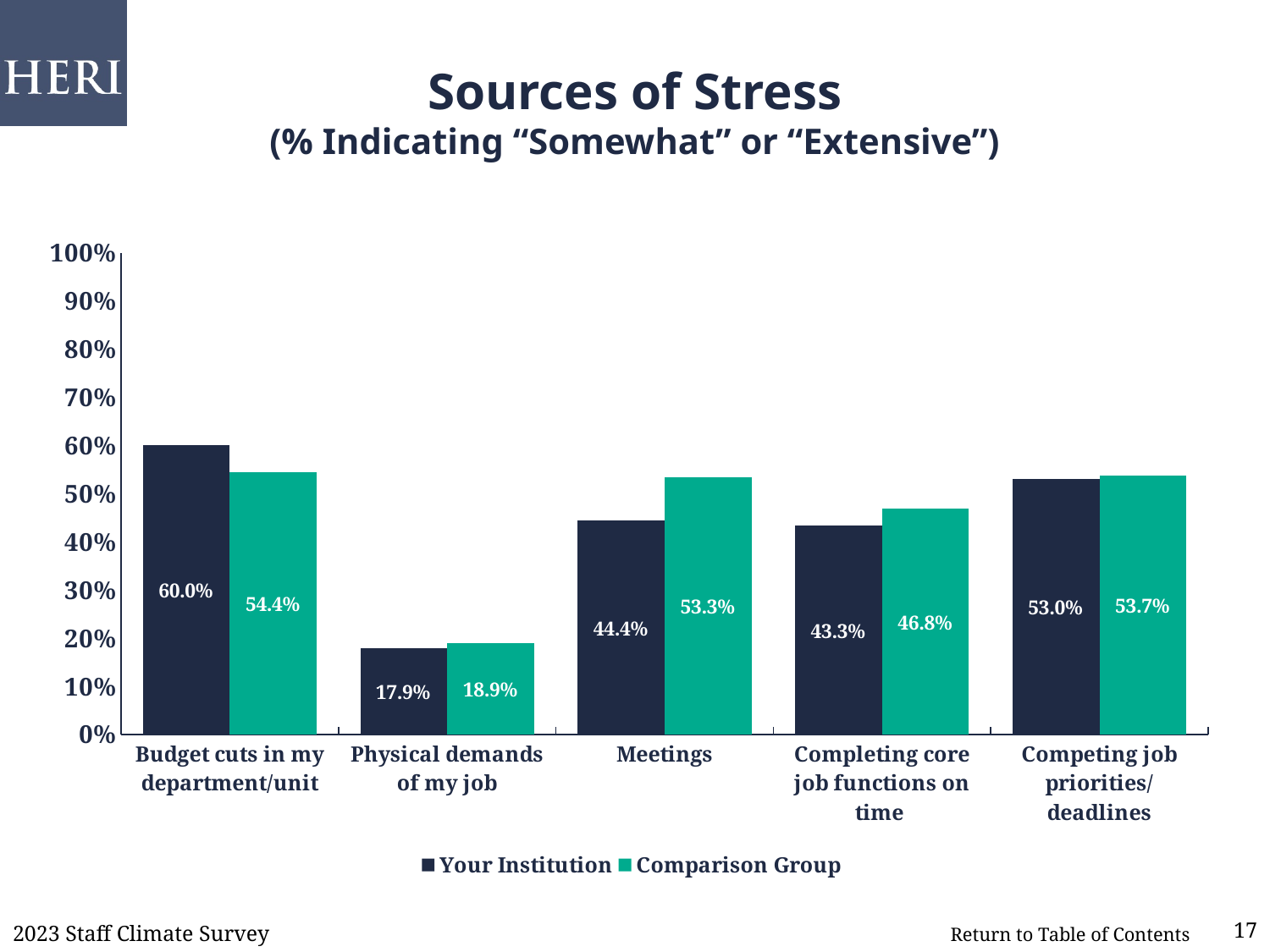
What is the subtitle shown under the chart title? (% Indicating "Somewhat" or "Extensive") Which category has the highest value for Your Institution? Budget cuts in my department/unit For Completing core job functions on time, which is larger: Your Institution or Comparison Group? Comparison Group What kind of chart is shown on the slide? Bar chart How many categories are shown on the x axis? 5 What is the difference between Comparison Group and Your Institution for Meetings? 8.9% What is the value for Your Institution for Budget cuts in my department/unit? 60.0% What is the value for Your Institution for Completing core job functions on time? 43.3% What is the value for Comparison Group for Meetings? 53.3% How many series does the legend list? 2 What is the difference between Your Institution and Comparison Group for Budget cuts in my department/unit? 5.6% Which category has the lowest value for Your Institution? Physical demands of my job